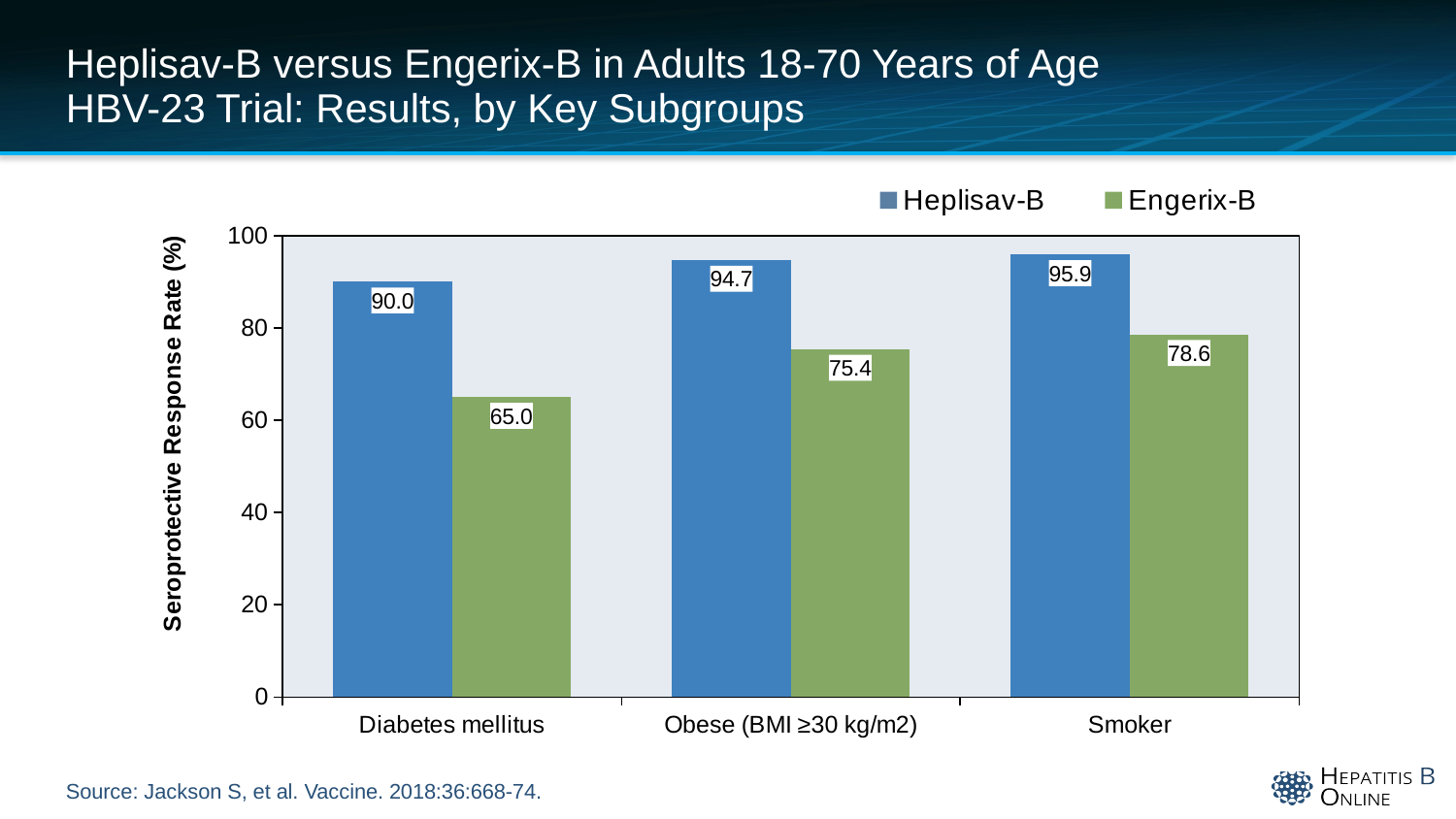
Is the Engerix-B seroprotective response rate in the Smoker subgroup greater or less than 80? less What is the seroprotective response rate for Heplisav-B in the Diabetes mellitus subgroup? 90.0 In which subgroup is the Engerix-B seroprotective response rate lowest? Diabetes mellitus In which subgroup is the Heplisav-B seroprotective response rate highest? Smoker What is the seroprotective response rate for Engerix-B in the Obese (BMI ≥30 kg/m2) subgroup? 75.4 What is the seroprotective response rate for Engerix-B in the Smoker subgroup? 78.6 What is the difference between the Heplisav-B and Engerix-B seroprotective response rates in the Diabetes mellitus subgroup? 25.0 What is the difference between the Heplisav-B and Engerix-B seroprotective response rates in the Smoker subgroup? 17.3 Which vaccine has the higher seroprotective response rate in the Obese (BMI ≥30 kg/m2) subgroup? Heplisav-B How many subgroups are shown on the x axis of the chart? 3 What type of chart is shown on the slide? Bar chart How many series does the chart legend list? 2